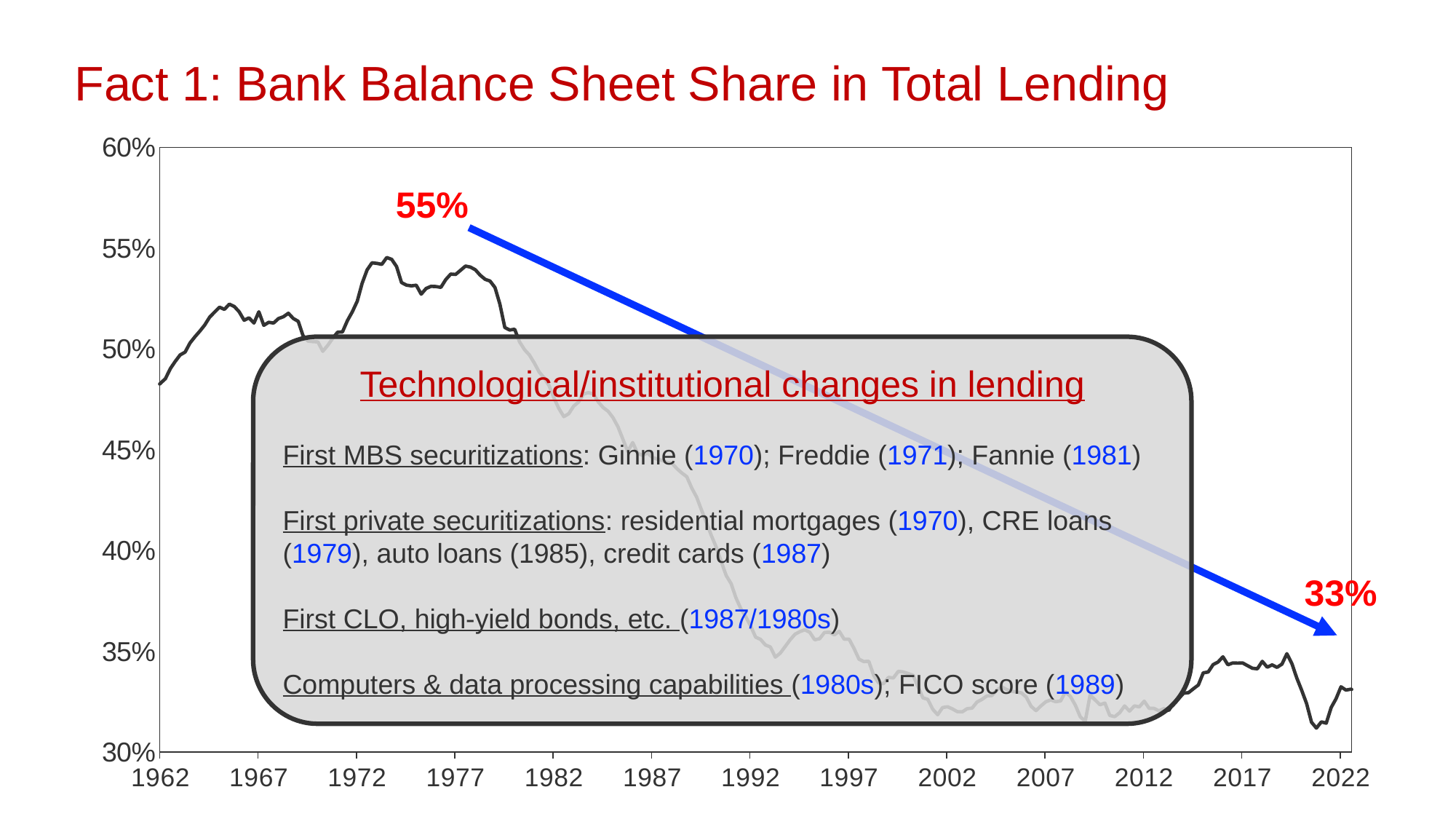
What kind of chart is shown on the slide? line chart Which is larger, the value in 1977 or the value in 2022? 1977 What is the difference between the two annotated values, 55% and 33%? 22 percentage points What is the title of the slide's chart? Fact 1: Bank Balance Sheet Share in Total Lending Is the value in 2022 greater or less than 35%? less Does the bank balance sheet share rise or fall overall from the late 1970s to 2022? fall What percentage label is printed near the peak of the line in the late 1970s? 55% How many year labels are shown on the x axis? 13 Is the value in 1967 greater or less than 50%? greater Is the value in 1977 greater or less than 50%? greater What percentage label is printed near the end of the series around 2022? 33%